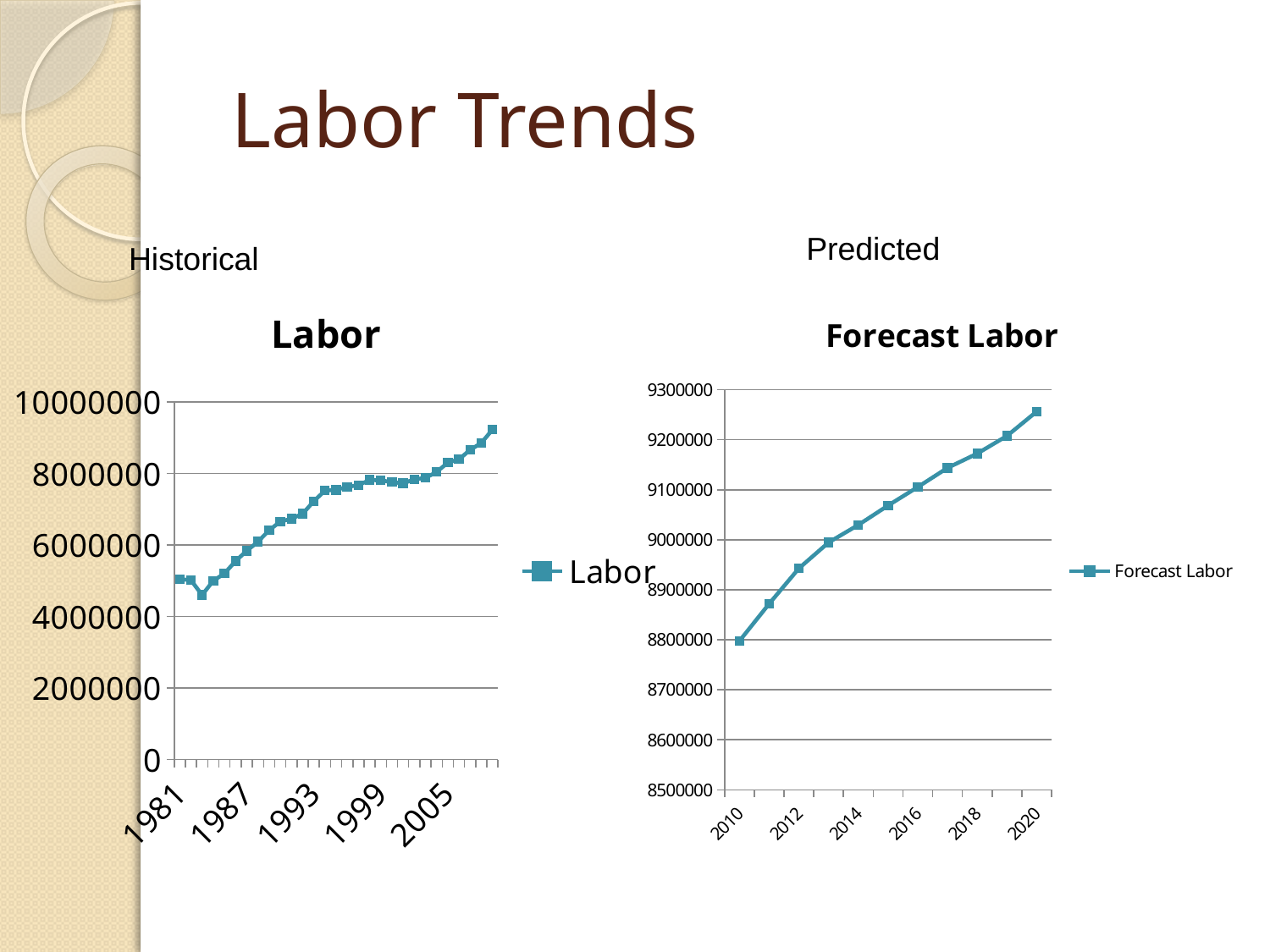
In the Forecast Labor chart, is the value for 2012 greater or less than 9000000? less In the Forecast Labor chart, which year has the highest value? 2020 In the Forecast Labor chart, is the value for 2020 greater or less than 9200000? greater In the Forecast Labor chart, which year has the lowest value? 2010 In the Forecast Labor chart, is the value for 2018 greater or less than 9100000? greater How many series does the legend of the Forecast Labor chart list? 1 In the Forecast Labor chart, do the values rise or fall from 2010 to 2020? rise What kind of chart is the Labor chart on the left? line chart What kind of chart is the Forecast Labor chart? line chart How many data points are plotted in the Forecast Labor chart? 11 What is the legend entry shown for the Forecast Labor chart? Forecast Labor